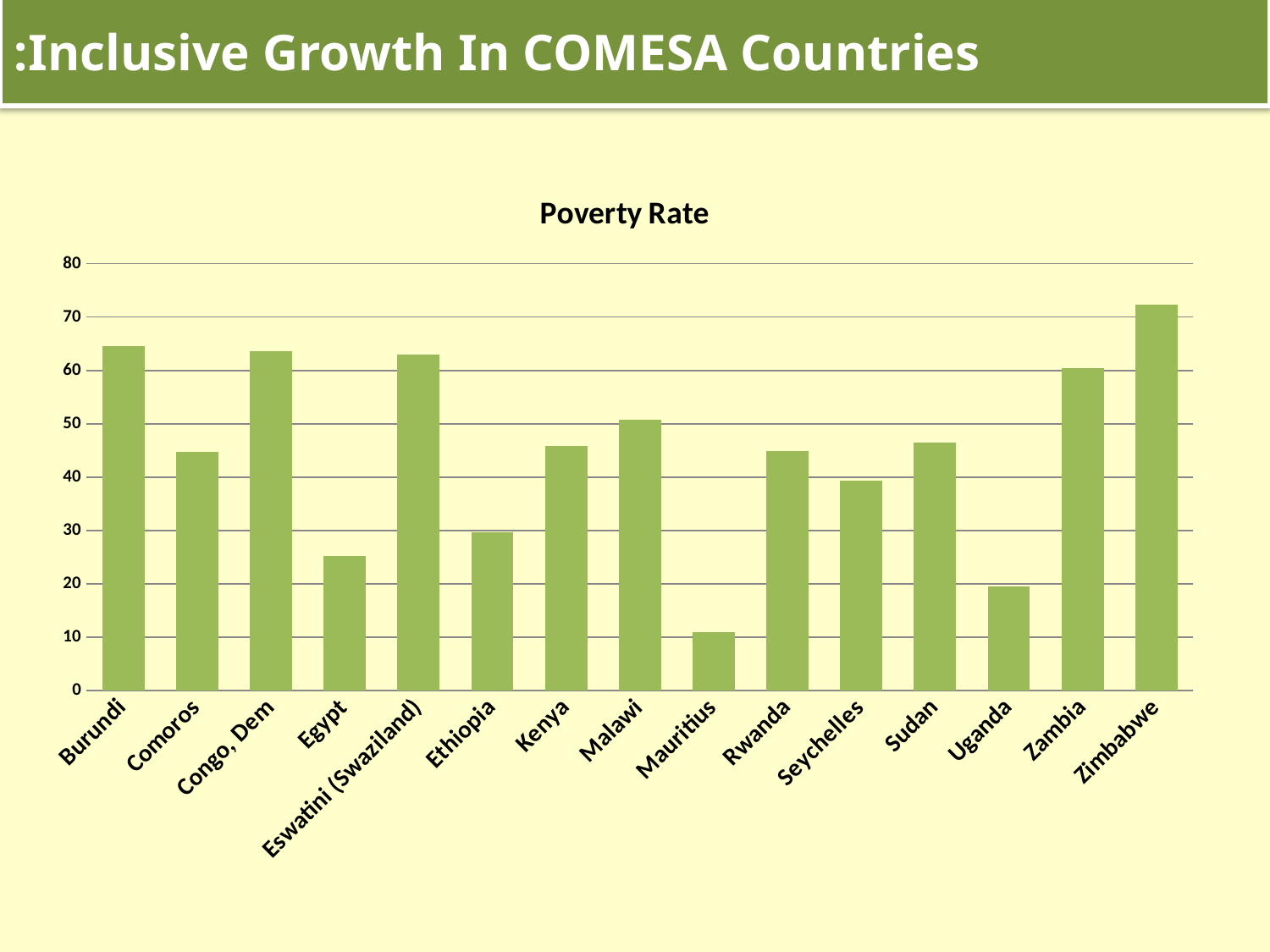
Which country has the highest poverty rate in the chart? Zimbabwe How many countries are shown on the x axis of the chart? 15 Is the poverty rate for Burundi greater or less than 60? greater Which has a higher poverty rate, Malawi or Kenya? Malawi Is the poverty rate for Uganda greater or less than 30? less Is the poverty rate for Zimbabwe greater or less than 70? greater Which country has the lowest poverty rate in the chart? Mauritius What is the title of the chart? Poverty Rate What kind of chart is shown on the slide? bar chart Which has a higher poverty rate, Burundi or Zambia? Burundi